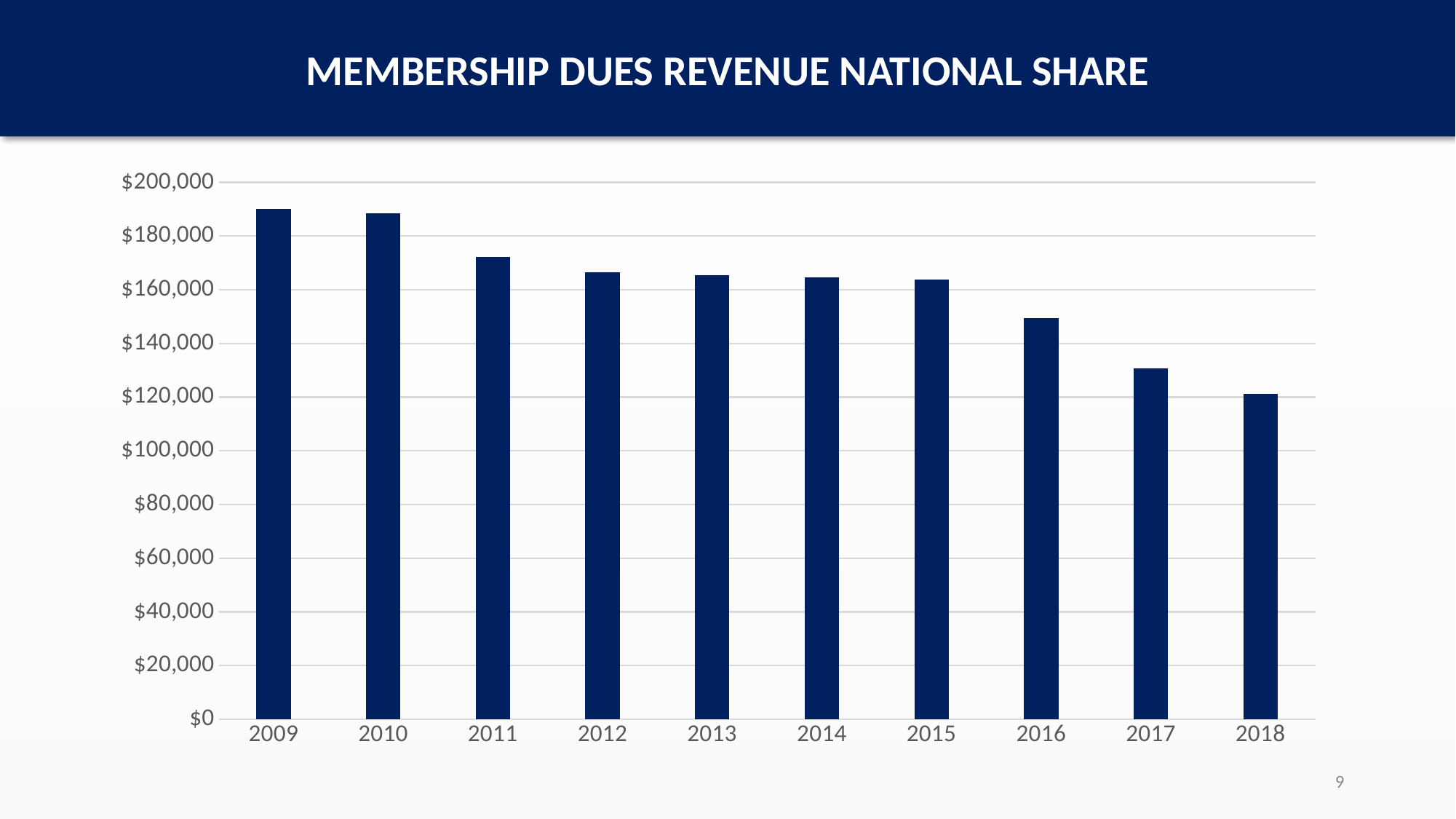
Which is larger, the value for 2017 or the value for 2018? 2017 Is the value for 2016 greater or less than $140,000? greater Is the value for 2018 greater or less than $140,000? less Is the value for 2011 greater or less than $160,000? greater What is the title of the slide's chart? MEMBERSHIP DUES REVENUE NATIONAL SHARE What kind of chart is shown on the slide? bar chart How many years are shown on the x axis of the chart? 10 Do the values generally rise or fall from 2009 to 2018? fall Which year has the lowest membership dues revenue national share? 2018 Which is larger, the value for 2011 or the value for 2016? 2011